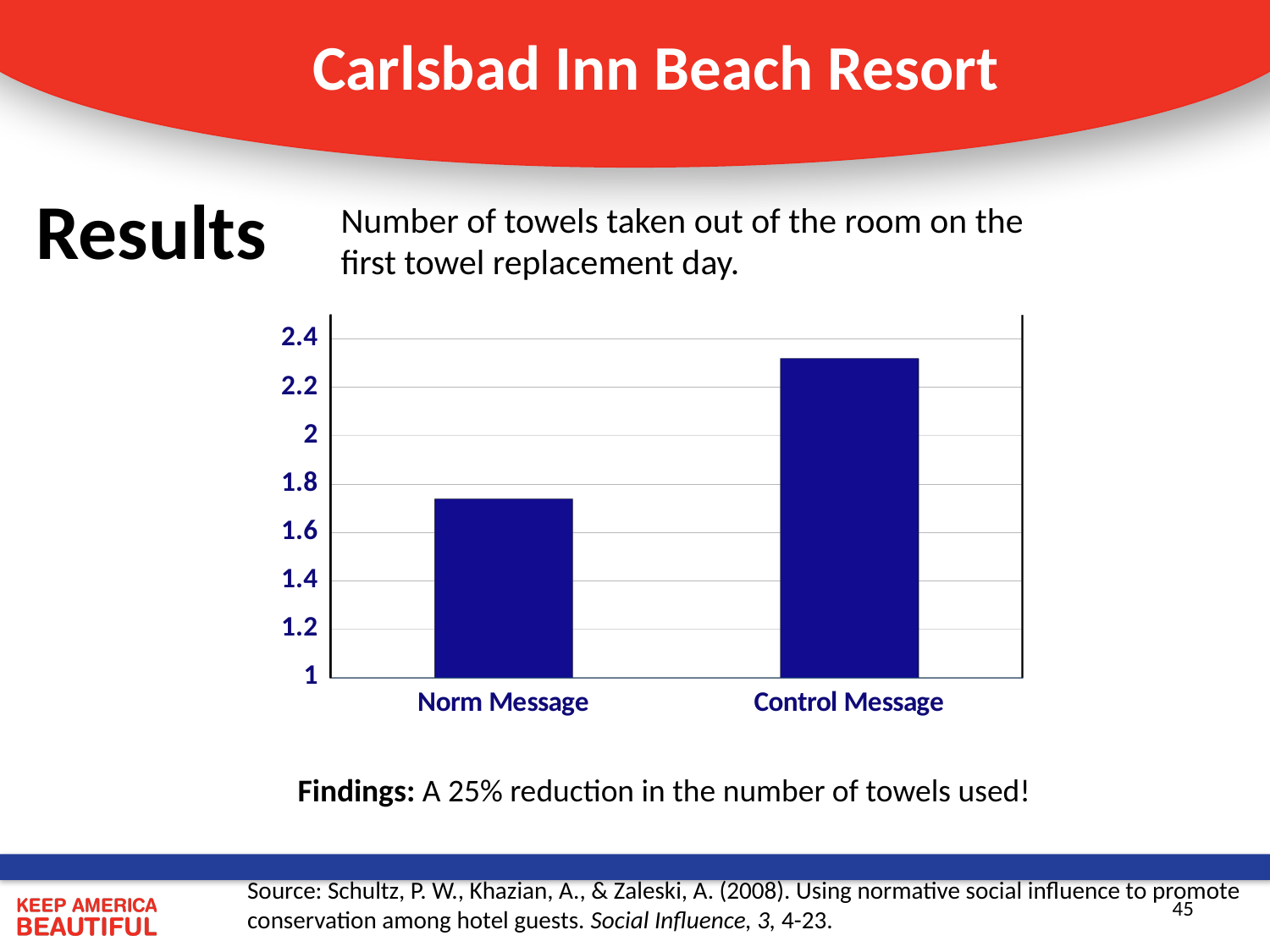
Is the value for Norm Message greater or less than 1.6? greater What kind of chart is shown on the slide? bar chart How many categories are plotted in the chart? 2 Is the value for Norm Message greater or less than 1.8? less What is the highest value shown on the chart's vertical axis? 2.4 What are the labels of the two categories on the x axis of the chart? Norm Message and Control Message Which is larger, the value for Norm Message or the value for Control Message? Control Message Is the value for Control Message greater or less than 2.4? less Which category has the highest value in the chart? Control Message Which category has the lowest value in the chart? Norm Message